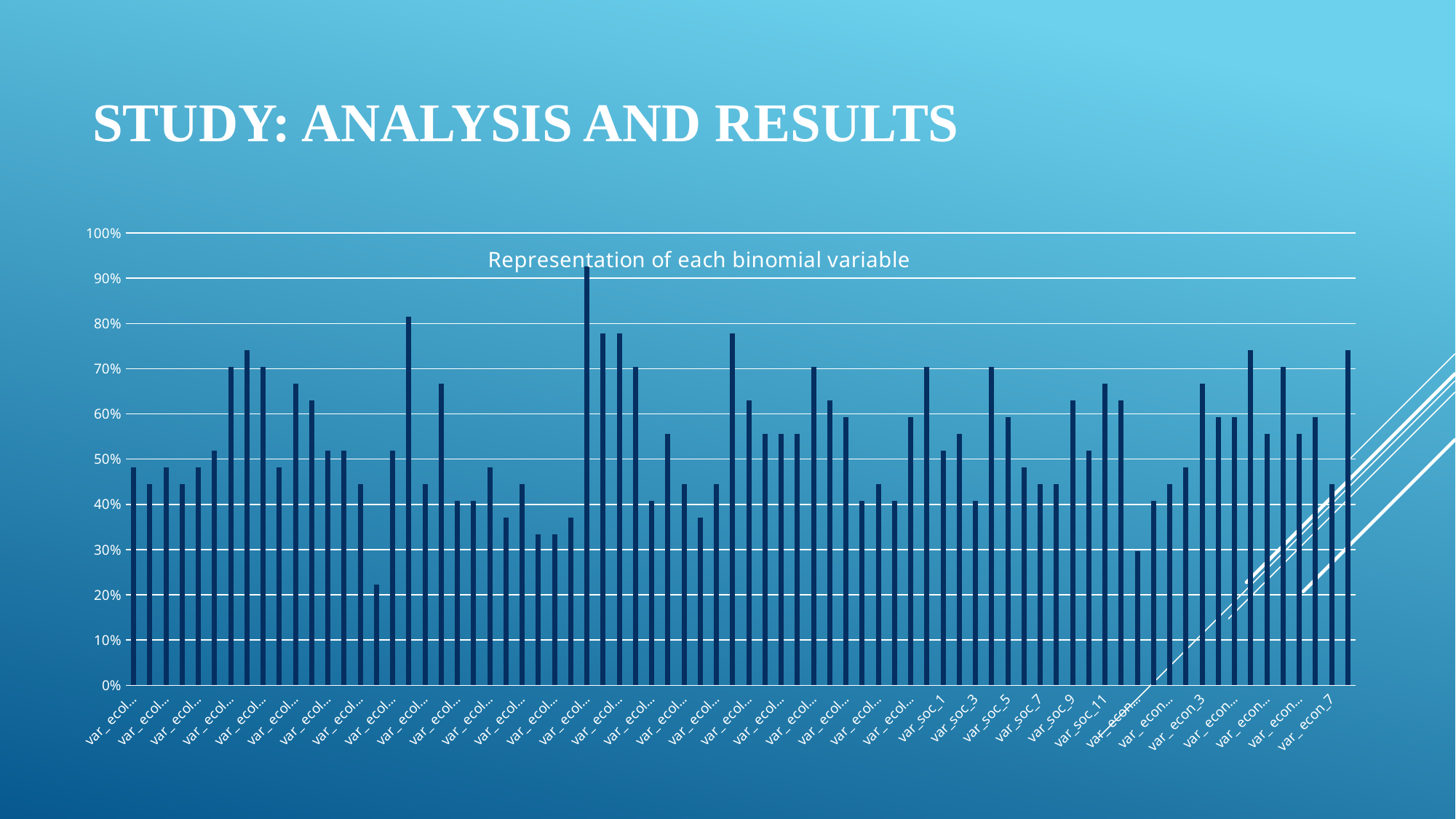
What is the highest value shown on the vertical axis of the chart? 100% Is the tallest bar in the chart greater or less than 90%? greater Is the shortest bar in the chart greater or less than 30%? less What kind of chart is shown on the slide? bar chart Is the tallest bar in the chart greater or less than 80%? greater What is the title of the chart? Representation of each binomial variable